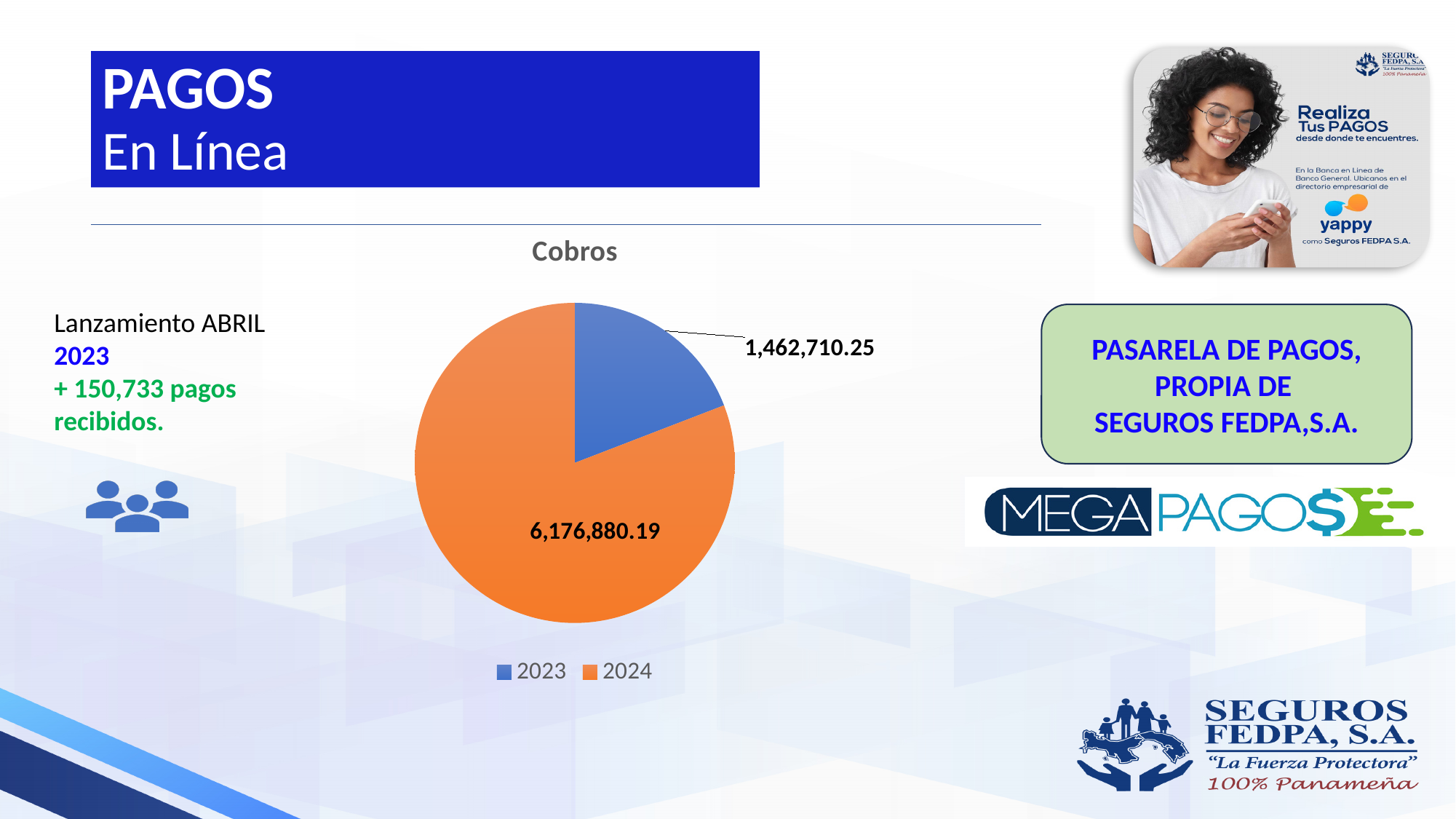
Which is larger in the Cobros pie chart, the value for 2023 or the value for 2024? 2024 What is the value shown for 2024 in the Cobros pie chart? 6,176,880.19 Which year has the largest slice in the Cobros pie chart? 2024 What is the total of the two slices in the Cobros pie chart? 7,639,590.44 What type of chart is shown under the title "Cobros"? Pie chart What is the value shown for 2023 in the Cobros pie chart? 1,462,710.25 How many slices does the Cobros pie chart have? 2 What is the title of the chart? Cobros How many entries does the legend of the Cobros pie chart list? 2 Which year has the smallest slice in the Cobros pie chart? 2023 What is the difference between the 2024 value and the 2023 value in the Cobros pie chart? 4,714,169.94 What colour is the 2024 slice in the Cobros pie chart? Orange